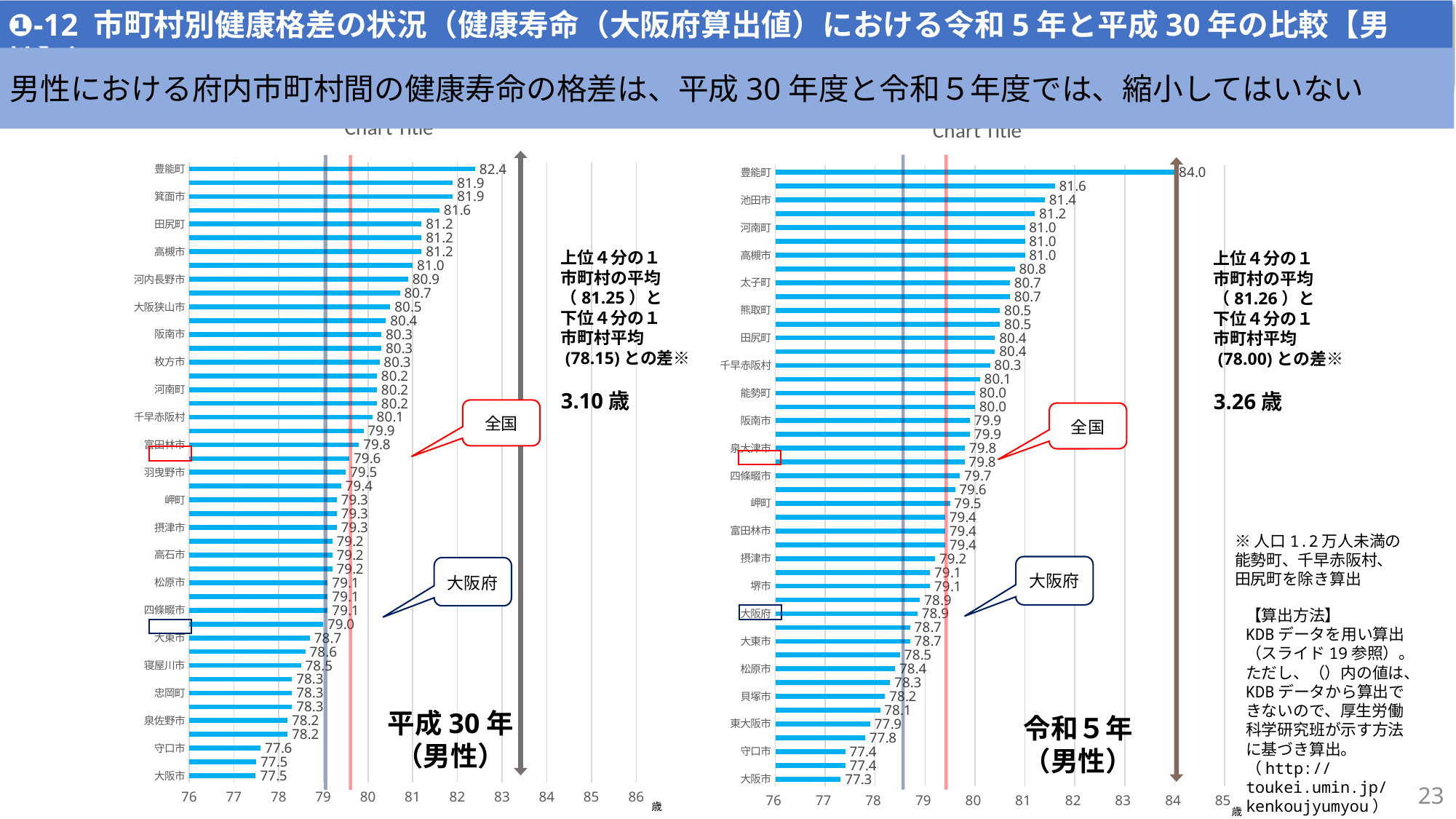
What kind of chart is the 平成30年（男性） chart on the left? bar chart In the 平成30年（男性） chart on the left, what is the value for 高槻市? 81.2 In the 令和5年（男性） chart on the right, what is the difference between the values for 豊能町 and 大阪市? 6.7 In the 平成30年（男性） chart on the left, is the value for 守口市 greater or less than 78? less In the 平成30年（男性） chart on the left, which municipality has the highest value? 豊能町 In the 平成30年（男性） chart on the left, what is the value for 豊能町? 82.4 In the 令和5年（男性） chart on the right, which municipality has the highest value? 豊能町 In the 令和5年（男性） chart on the right, which has the larger value, 池田市 or 守口市? 池田市 In the 令和5年（男性） chart on the right, what is the value for 大阪市? 77.3 In the 令和5年（男性） chart on the right, what is the value for 大阪府? 78.9 In the 平成30年（男性） chart on the left, what is the value for 大阪市? 77.5 In the 令和5年（男性） chart on the right, what is the value for 豊能町? 84.0